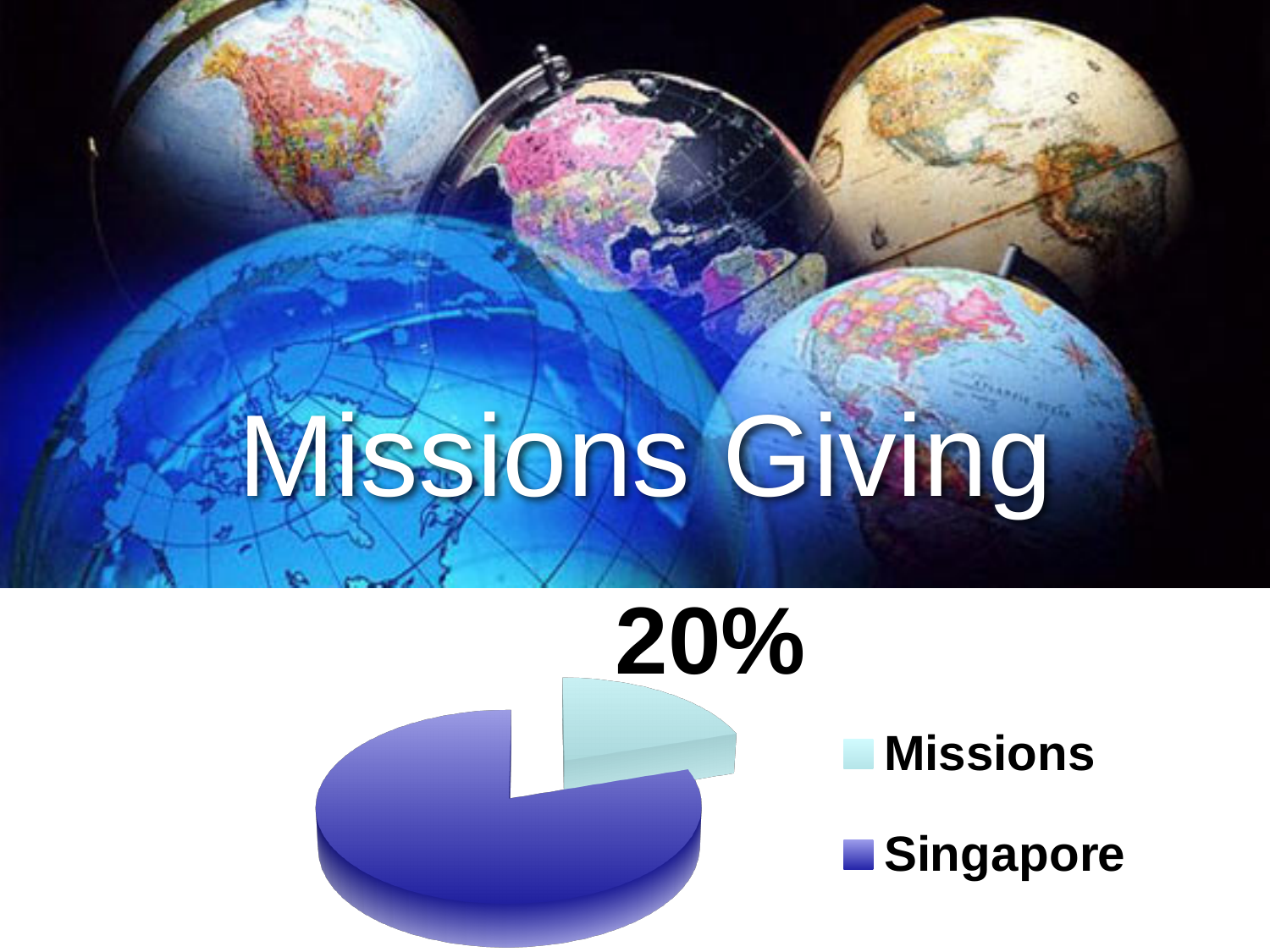
Which legend entry is shown in the light blue colour? Missions What is the title shown on the slide above the chart? Missions Giving What share of the pie does the Missions slice represent? 20% How many entries does the chart legend list? 2 How many categories are shown in the pie chart? 2 Which slice is larger, Missions or Singapore? Singapore Which category has the largest slice of the pie chart? Singapore Which category has the smallest slice of the pie chart? Missions What kind of chart is shown on the slide? Pie chart What percentage of the pie chart is labelled for Missions? 20%